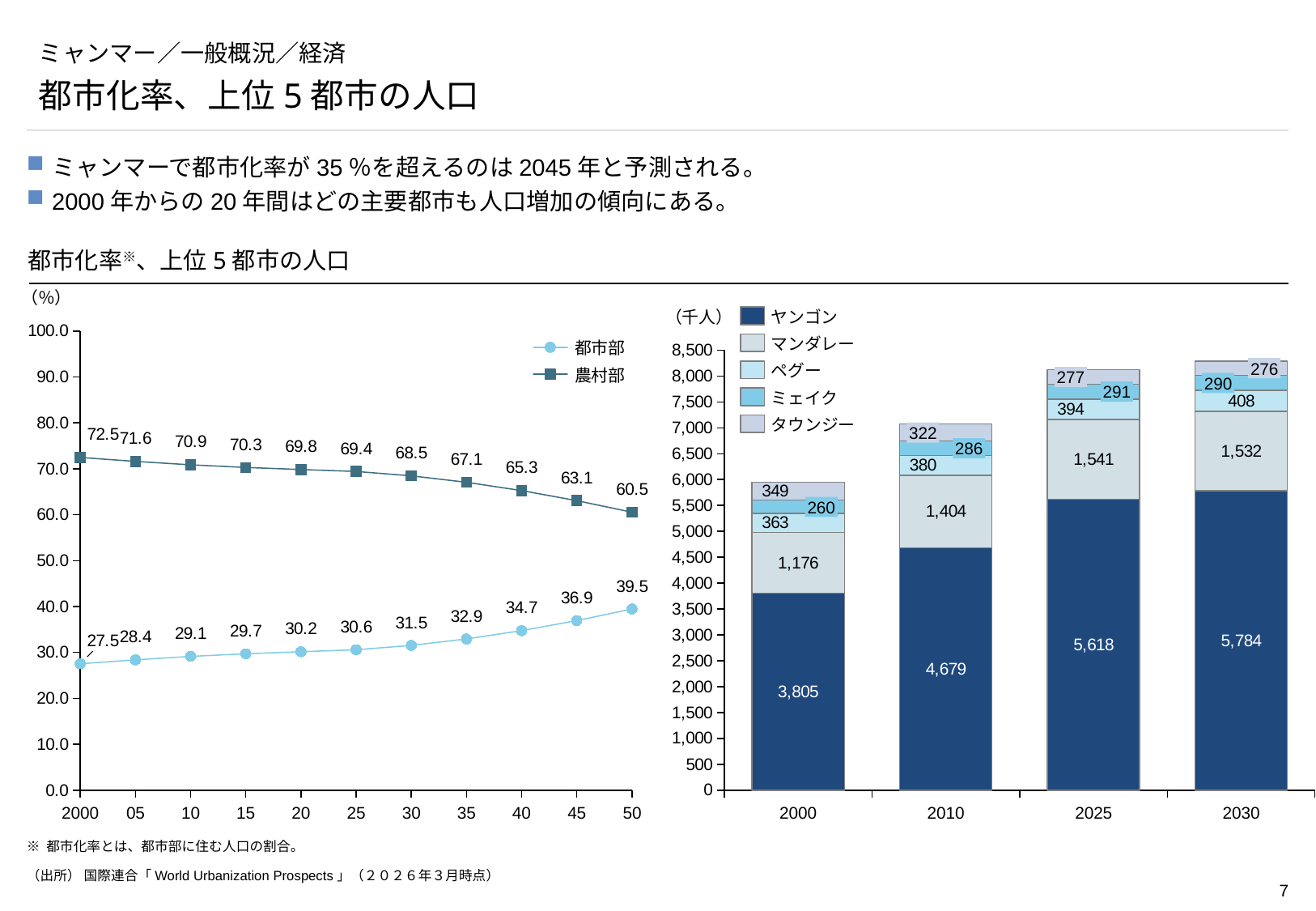
In the right stacked bar chart, what is the total of the stacked bar for 2000? 5,953 In the right stacked bar chart, what is the value for マンダレー in 2025? 1,541 What kind of chart is the chart on the right side of the slide? stacked bar chart How many series does the legend of the left line chart list? 2 In the right stacked bar chart, which is larger in 2030: ペグー or ミェイク? ペグー In the right stacked bar chart, what is the value for ヤンゴン in 2010? 4,679 In the left line chart, what is the value for 農村部 in 2000? 72.5 In the right stacked bar chart, which year has the highest value for ヤンゴン? 2030 In the left line chart, what is the value for 都市部 in 2050? 39.5 How many series does the legend of the right stacked bar chart list? 5 In the left line chart, what is the difference between the 農村部 and 都市部 values in 2030? 37.0 In the left line chart, does the 都市部 series rise or fall from 2000 to 2050? rise